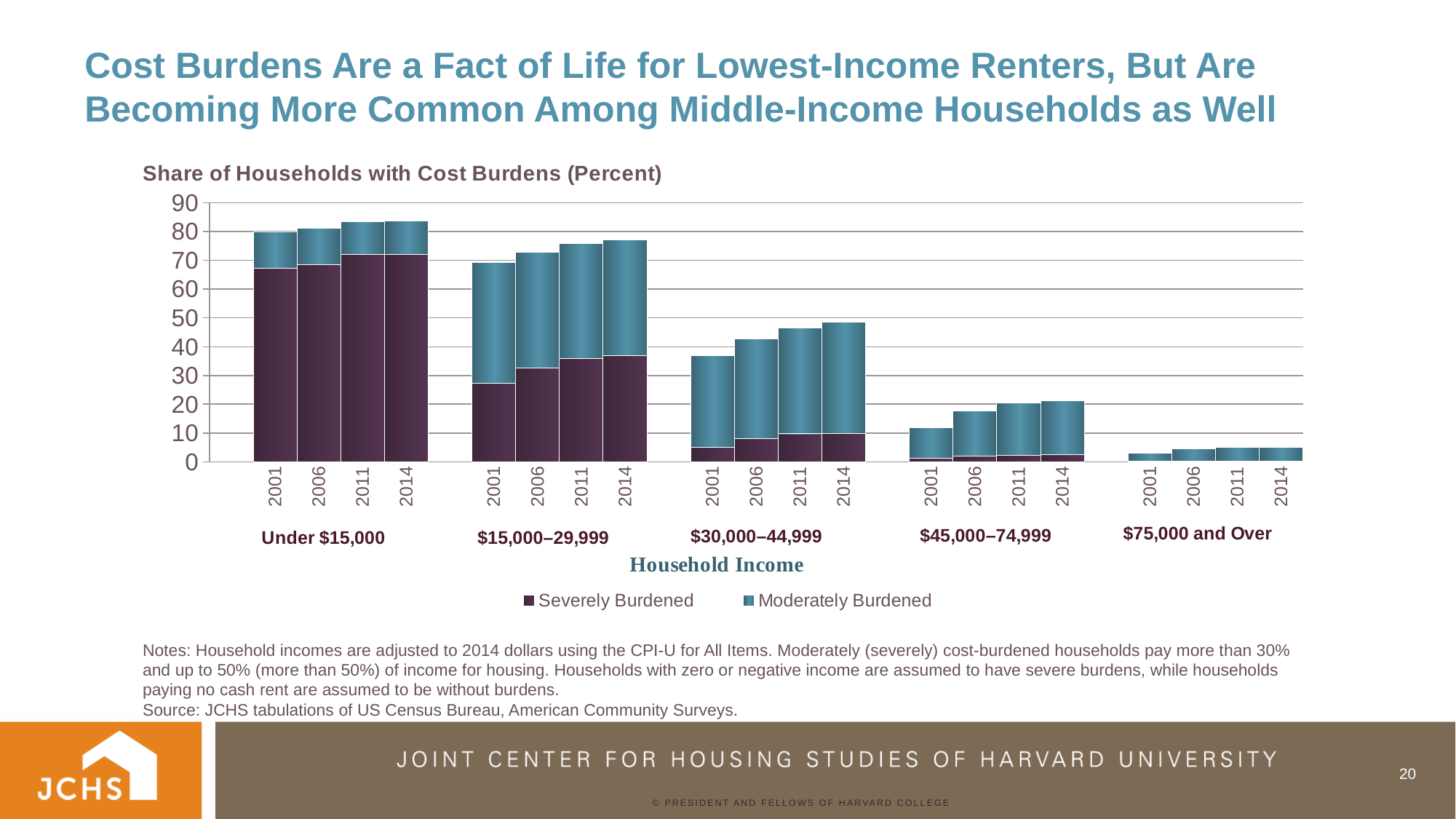
Is the total share of cost-burdened households for Under $15,000 in 2014 greater or less than 80? greater Which is larger: the total share for $30,000–44,999 in 2001 or the total share for $45,000–74,999 in 2014? $30,000–44,999 in 2001 What are the two series named in the legend? Severely Burdened and Moderately Burdened How many years are plotted for each household income group? 4 Within the $15,000–29,999 income group, does the total share of cost-burdened households rise or fall from 2001 to 2014? rise How many household income groups are shown along the x axis? 5 What kind of chart is shown on the slide? Stacked bar chart Is the total share of cost-burdened households for $30,000–44,999 in 2001 greater or less than 40? less Is the total share of cost-burdened households for $45,000–74,999 in 2014 greater or less than 30? less How many series does the legend list? 2 Which household income group has the lowest total share of cost-burdened households in 2014? $75,000 and Over Which household income group has the highest total share of cost-burdened households in 2014? Under $15,000